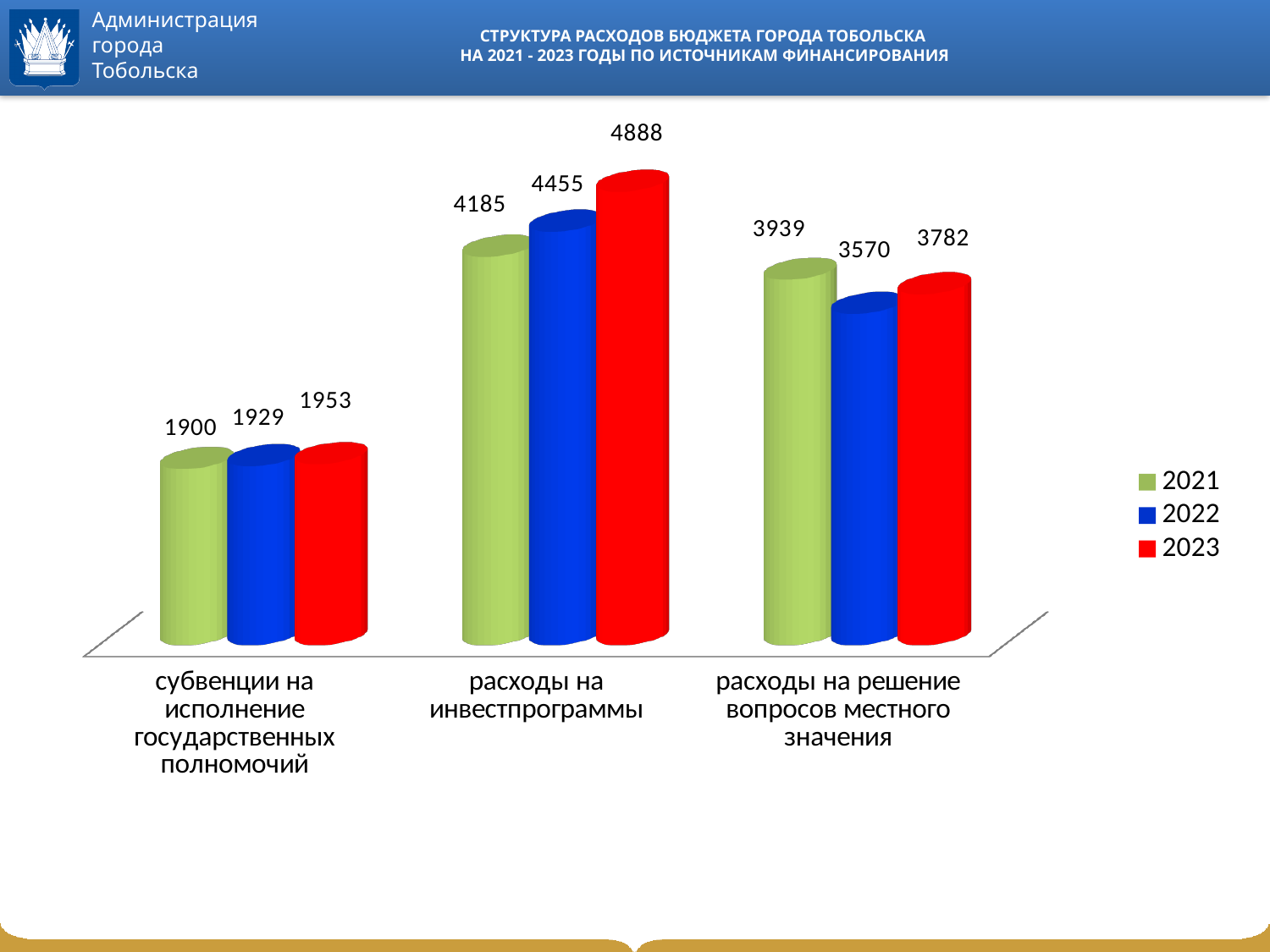
What is the value for 2021 in the "субвенции на исполнение государственных полномочий" category? 1900 Which category has the highest value for 2022? расходы на инвестпрограммы How many series does the legend list? 3 Do the values for "субвенции на исполнение государственных полномочий" rise or fall from 2021 to 2023? rise What is the value for 2023 in the "расходы на инвестпрограммы" category? 4888 Which is larger for "расходы на решение вопросов местного значения": the 2021 value or the 2023 value? 2021 What is the difference between the 2023 and 2021 values for "расходы на инвестпрограммы"? 703 What kind of chart is shown on the slide? bar chart How many categories are shown on the x axis? 3 Which colour represents the 2022 series in the legend? blue What is the value for 2022 in the "расходы на решение вопросов местного значения" category? 3570 Which category has the lowest value for 2023? субвенции на исполнение государственных полномочий